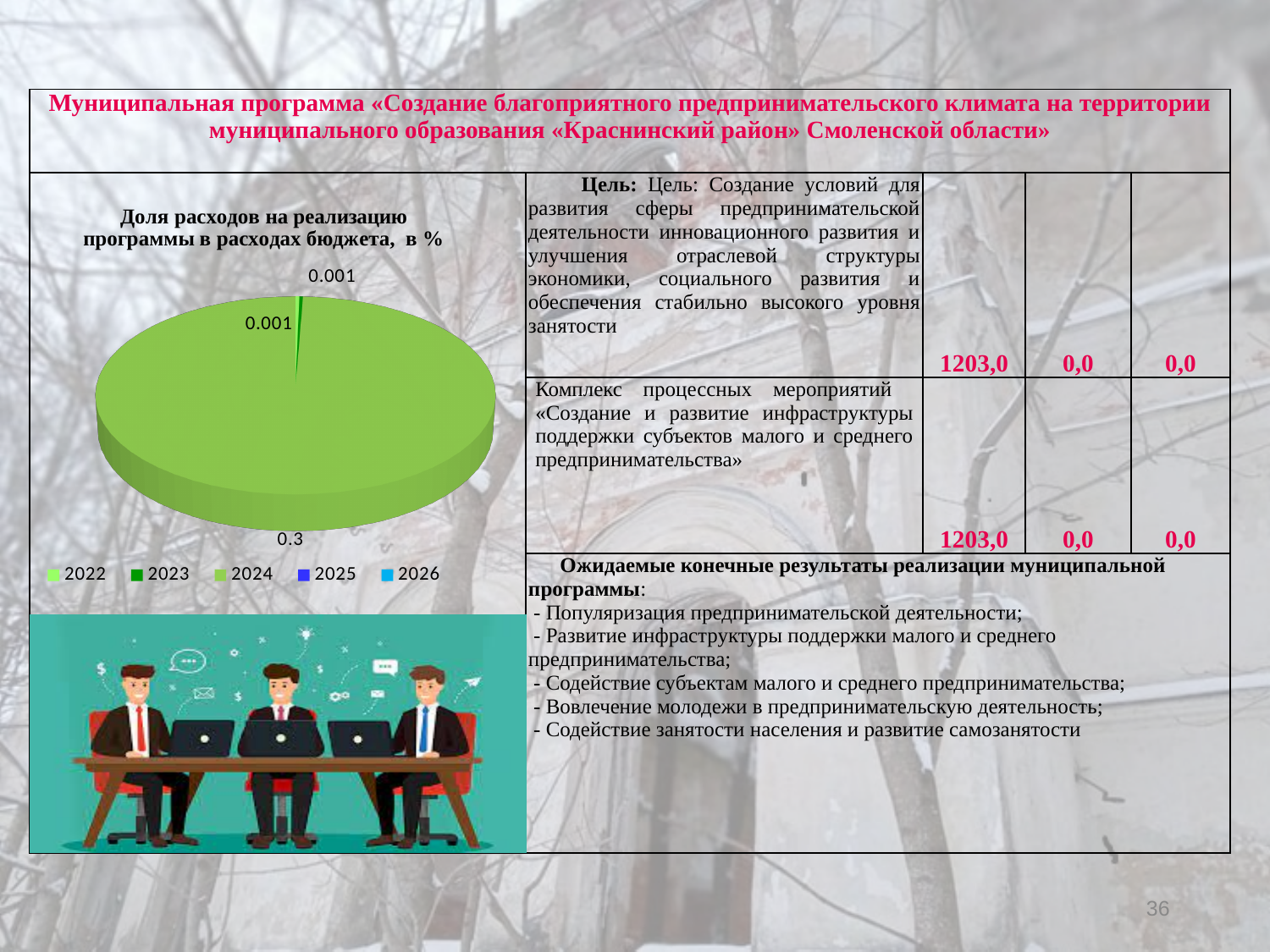
Which is larger on the pie chart, the slice labelled 0.3 or a slice labelled 0.001? 0.3 What is the difference between the slice labelled 0.3 and a slice labelled 0.001 on the pie chart? 0.299 What is the smallest value labelled on the pie chart? 0.001 How many entries does the legend of the pie chart list? 5 What is the title of the pie chart? Доля расходов на реализацию программы в расходах бюджета, в % What is the largest value labelled on the pie chart? 0.3 Which years are listed in the legend of the pie chart? 2022, 2023, 2024, 2025, 2026 What kind of chart is shown on the slide? pie chart Is the largest labelled value on the pie chart greater or less than 0.1? greater How many data labels are printed on the pie chart? 3